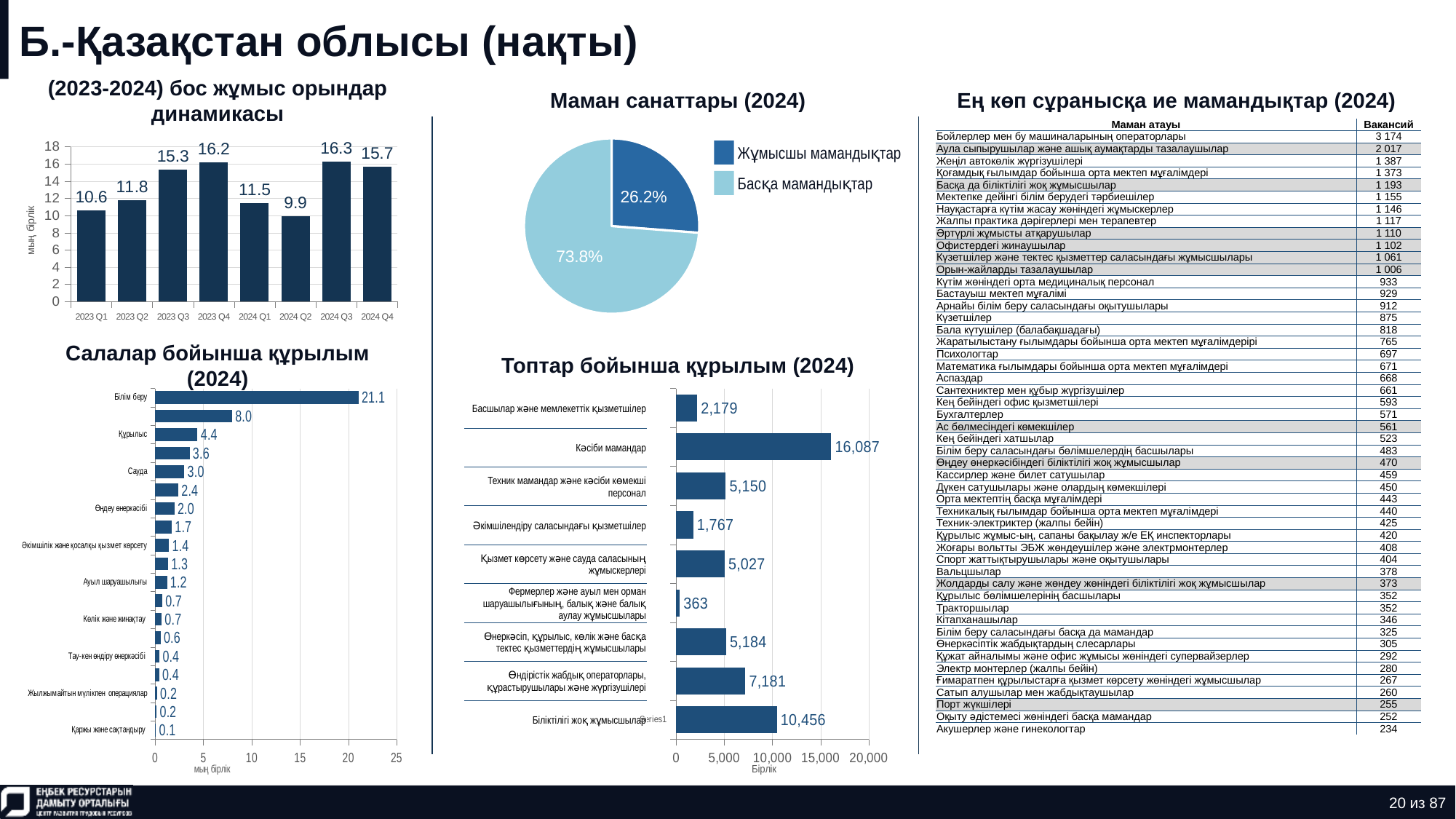
In the pie chart 'Маман санаттары (2024)', what share does 'Жұмысшы мамандықтар' have? 26.2% In the chart 'Топтар бойынша құрылым (2024)', which category has the lowest value? Фермерлер және ауыл мен орман шаруашылығының, балық және балық аулау жұмысшылары In the chart 'Топтар бойынша құрылым (2024)', how many categories are plotted? 9 In the chart '(2023-2024) бос жұмыс орындар динамикасы', what is the value for 2023 Q4? 16.2 In the chart '(2023-2024) бос жұмыс орындар динамикасы', how many quarters are plotted? 8 In the chart '(2023-2024) бос жұмыс орындар динамикасы', which quarter has the highest value? 2024 Q3 In the chart 'Салалар бойынша құрылым (2024)', what is the value for 'Білім беру'? 21.1 In the chart '(2023-2024) бос жұмыс орындар динамикасы', what is the difference between the values for 2023 Q1 and 2023 Q2? 1.2 In the chart 'Топтар бойынша құрылым (2024)', what is the value for 'Кәсіби мамандар'? 16,087 In the chart '(2023-2024) бос жұмыс орындар динамикасы', which quarter has the lowest value? 2024 Q2 How many entries does the legend of the pie chart 'Маман санаттары (2024)' list? 2 In the chart 'Топтар бойынша құрылым (2024)', which is larger: 'Өндірістік жабдық операторлары, құрастырушылары және жүргізушілері' or 'Біліктілігі жоқ жұмысшылар'? Біліктілігі жоқ жұмысшылар